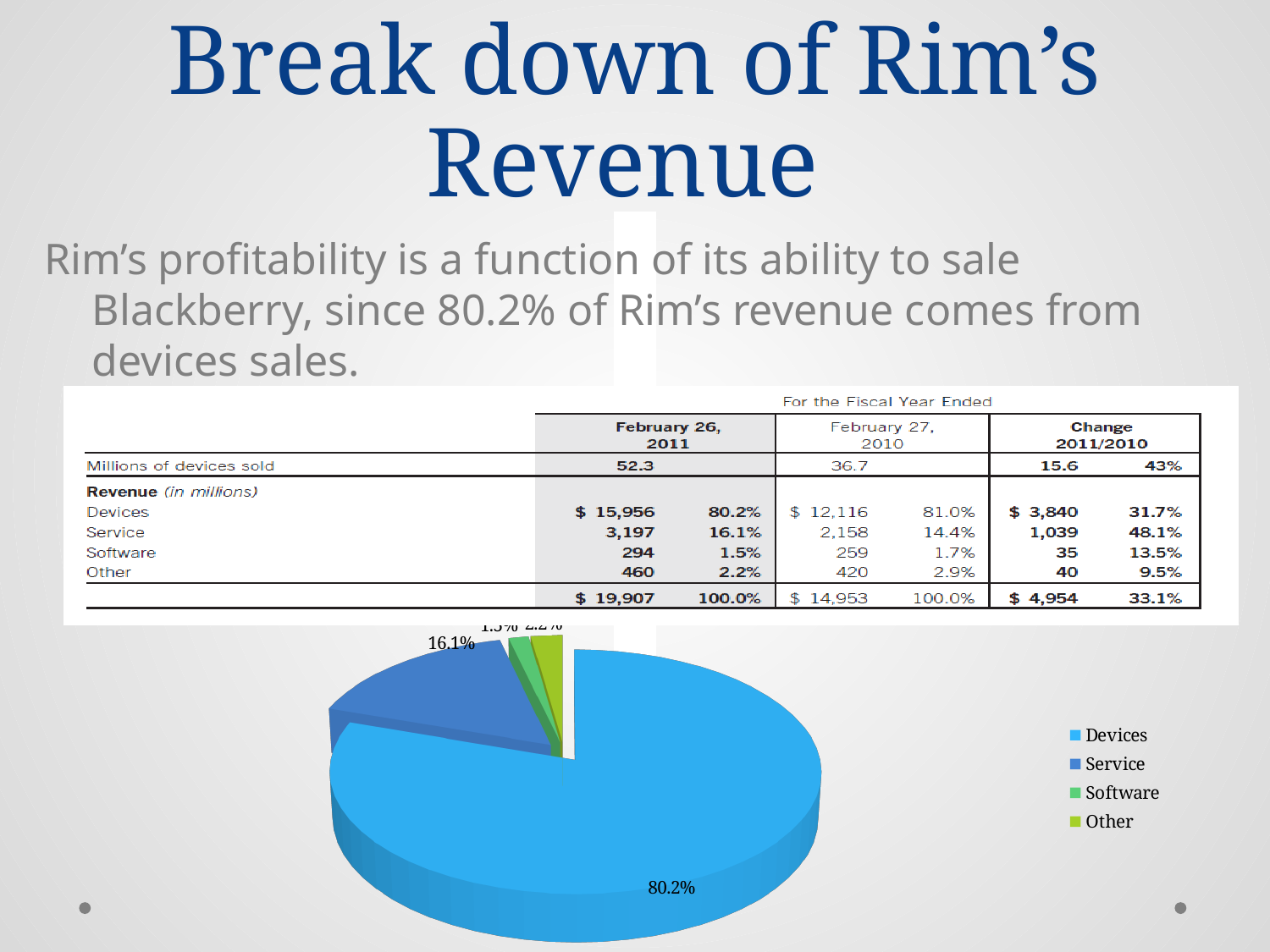
What share of the pie does Devices represent? 80.2% Which category has the smallest slice of the pie? Software Which category has the largest slice of the pie? Devices How many series does the pie chart's legend list? 4 What is the difference in percentage points between the Devices slice and the Service slice? 64.1 What colour is the Devices slice of the pie? light blue Is the share for Service greater or less than 25%? less Which legend entry is listed last in the pie chart's legend? Other Is the share for Devices greater or less than 50%? greater What kind of chart is shown on the slide? pie chart Which slice is larger, Devices or Service? Devices What share of the pie does Service represent? 16.1%